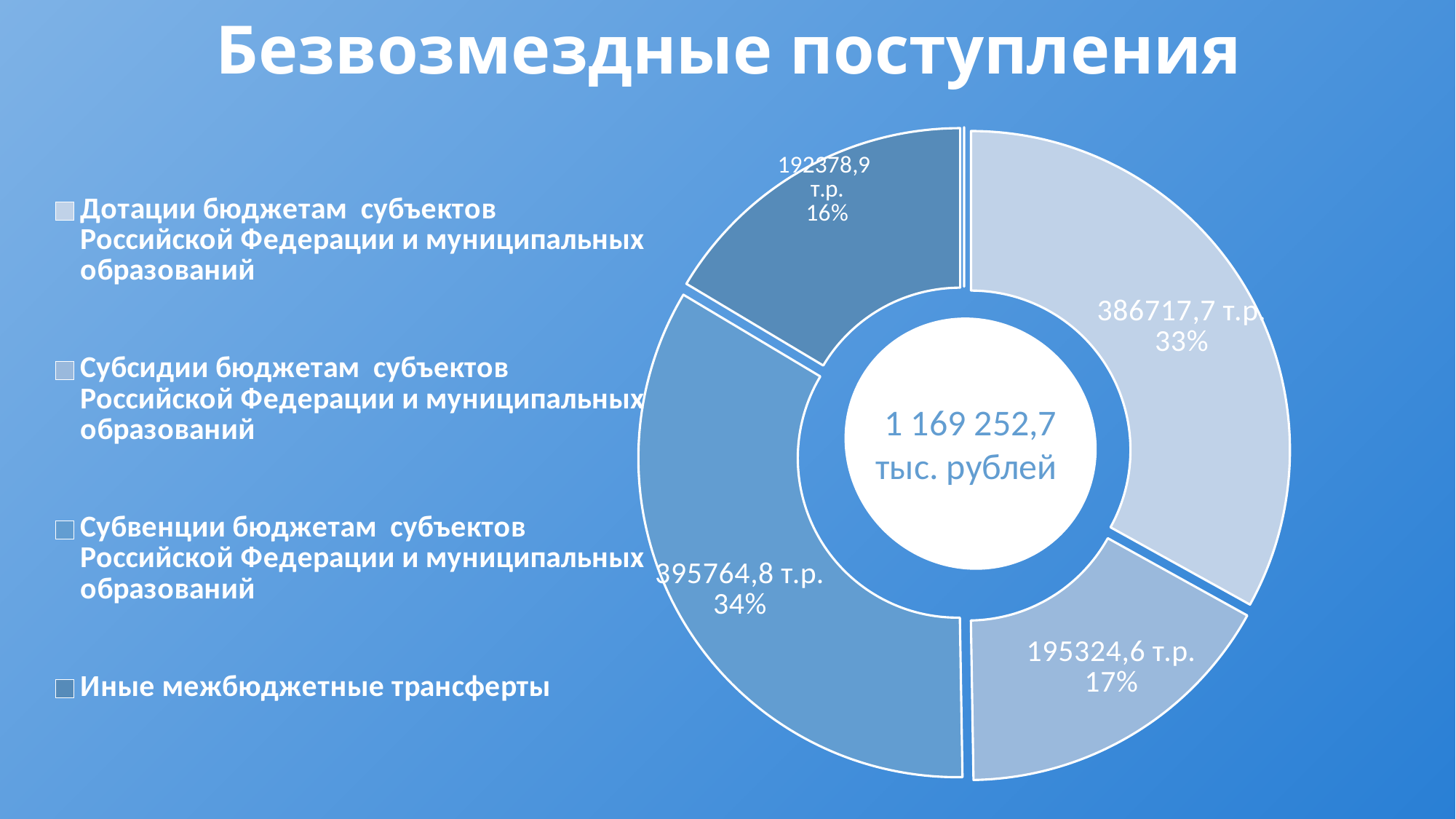
Which category has the largest share of the chart? Субвенции бюджетам субъектов Российской Федерации и муниципальных образований Which is larger: the value for Субсидии or the value for Иные межбюджетные трансферты? Субсидии What is the value for Иные межбюджетные трансферты? 192378,9 т.р. What kind of chart is shown on the slide? Pie (doughnut) chart What is the difference between the values for Субвенции and Дотации? 9047,1 т.р. How many entries does the legend list? 4 What total is shown in the centre of the chart? 1 169 252,7 тыс. рублей What is the value for Дотации бюджетам субъектов Российской Федерации и муниципальных образований? 386717,7 т.р. What is the value for Субвенции бюджетам субъектов Российской Федерации и муниципальных образований? 395764,8 т.р. What share of the chart does Субсидии бюджетам субъектов Российской Федерации и муниципальных образований represent? 17% How many slices does the chart have? 4 Which category has the smallest share of the chart? Иные межбюджетные трансферты